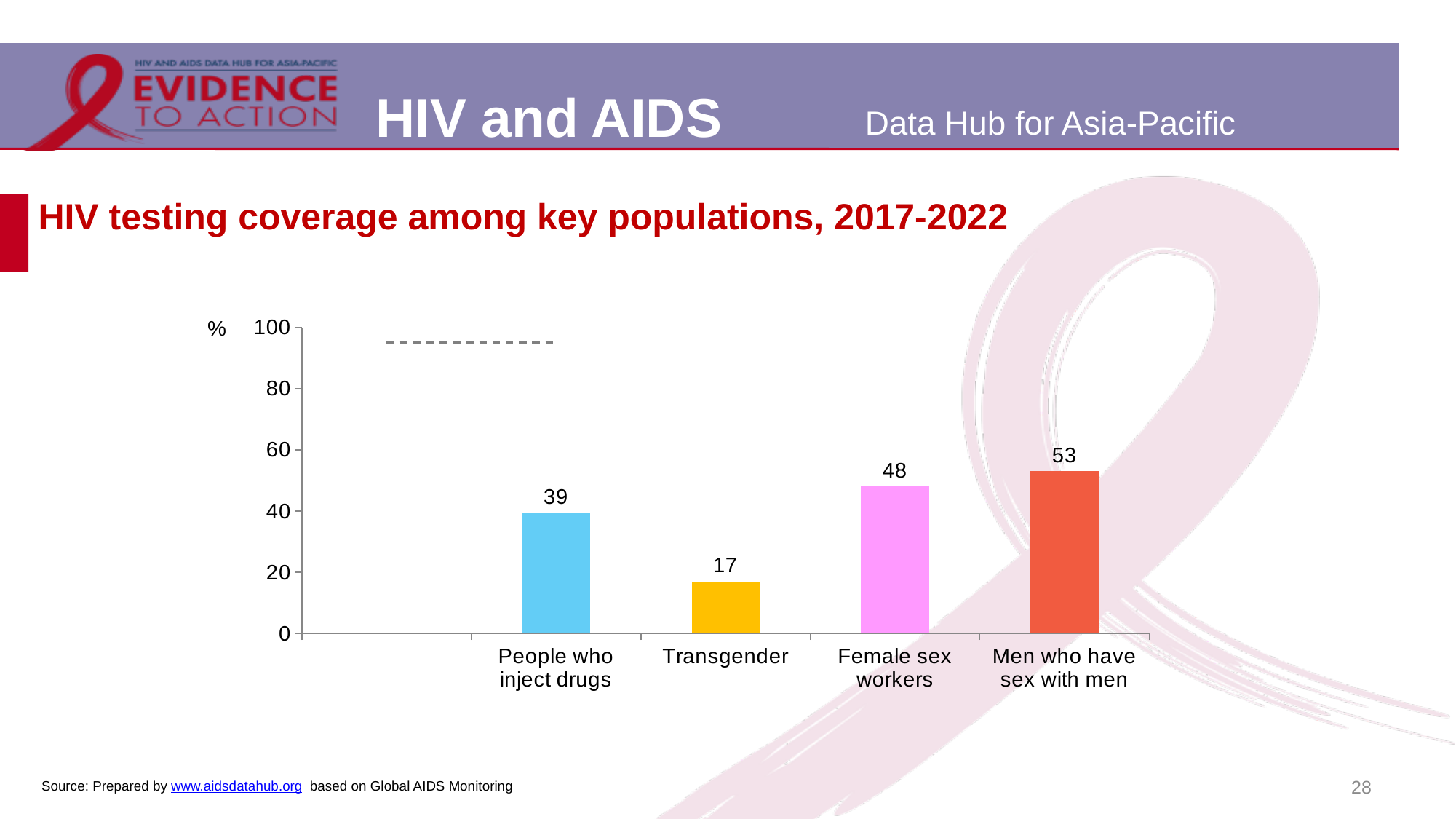
What is the title of the chart on the slide? HIV testing coverage among key populations, 2017-2022 Which key population has the highest HIV testing coverage? Men who have sex with men What is the HIV testing coverage value for Transgender? 17 What is the HIV testing coverage value for People who inject drugs? 39 How many key populations are shown on the chart? 4 What is the difference between the values for Female sex workers and People who inject drugs? 9 What is the HIV testing coverage value for Female sex workers? 48 What is the difference between the values for Men who have sex with men and Transgender? 36 Which is larger, the value for Female sex workers or the value for People who inject drugs? Female sex workers What kind of chart is shown on the slide? Bar chart What is the HIV testing coverage value for Men who have sex with men? 53 Which key population has the lowest HIV testing coverage? Transgender